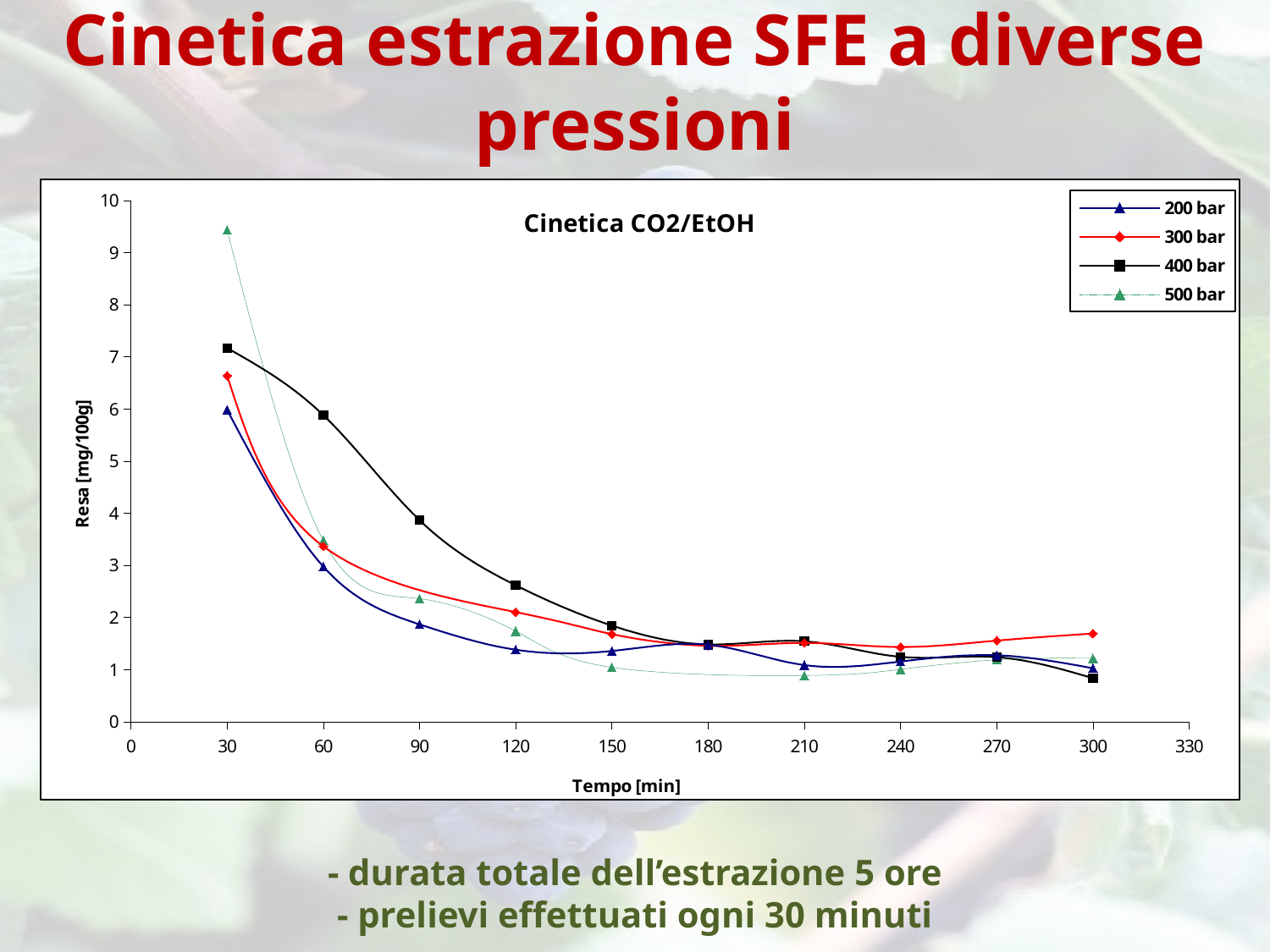
What is the title printed inside the chart area? Cinetica CO2/EtOH Is the value for 200 bar at 120 min greater or less than 2? less Is the value for 500 bar at 30 min greater or less than 9? greater At 90 min, which is larger: the value for 400 bar or the value for 300 bar? 400 bar Which series has the lowest value at 30 min? 200 bar Do the values for the 400 bar series rise or fall as time increases along the x axis? fall Which series has the highest value at 300 min? 300 bar What kind of chart is shown on the slide? line chart Is the value for 400 bar at 60 min greater or less than 5? greater Which series has the highest value at 30 min? 500 bar How many series does the legend list? 4 How many data points are plotted for the 400 bar series? 10